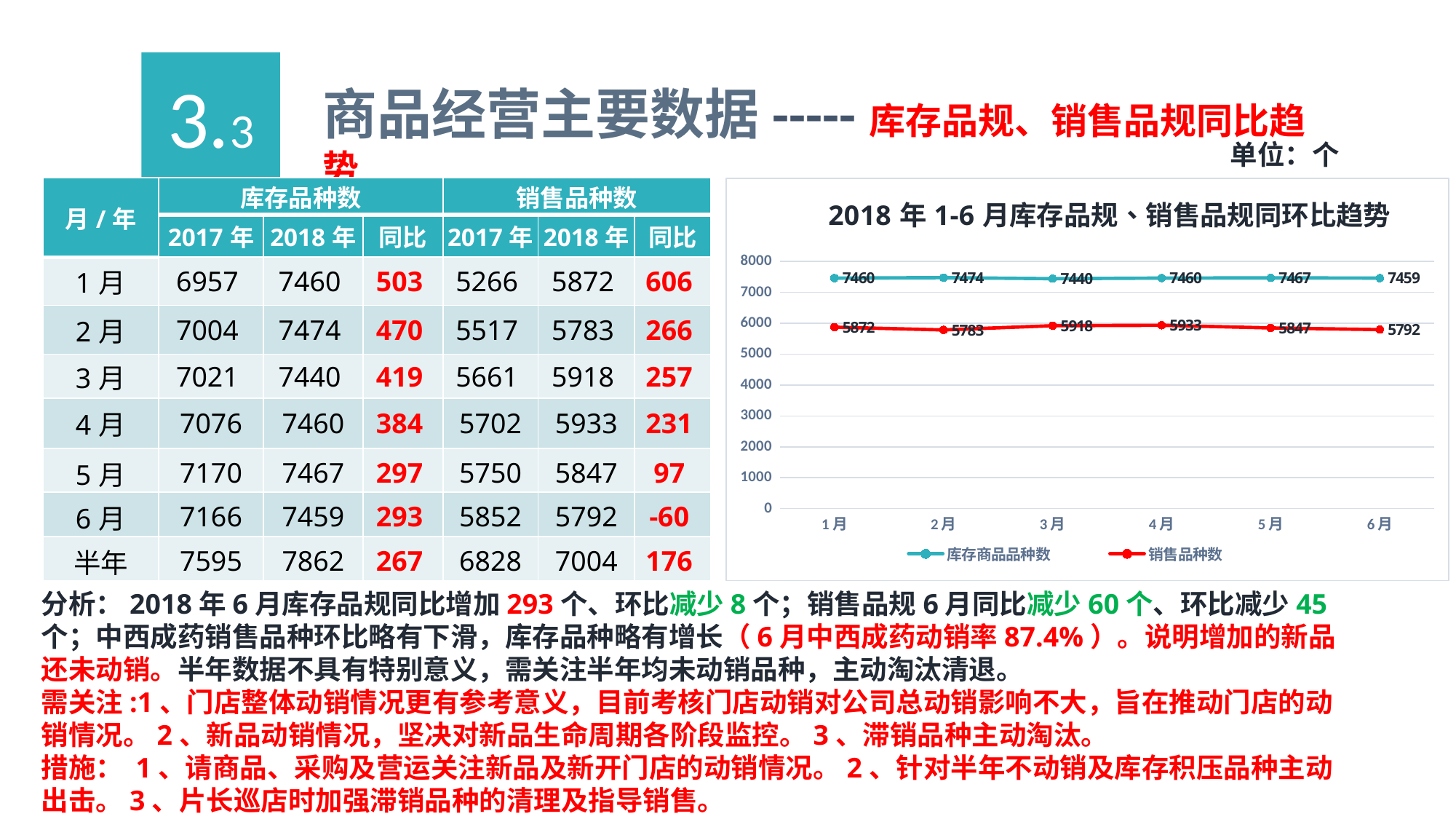
How many months are plotted along the x axis of the chart? 6 What type of chart is shown on the slide? Line chart What is the value of 销售品种数 in 6月? 5792 In which month is 销售品种数 lowest? 2月 How many series does the chart legend list? 2 What is the value of 库存商品品种数 in 2月? 7474 Is the value of 销售品种数 in 5月 greater or less than 6000? less What is the title of the chart? 2018年1-6月库存品规、销售品规同环比趋势 What is the value of 销售品种数 in 4月? 5933 Which series has the higher value in 3月, 库存商品品种数 or 销售品种数? 库存商品品种数 In which month is 销售品种数 highest? 4月 What is the difference between 库存商品品种数 and 销售品种数 in 1月? 1588